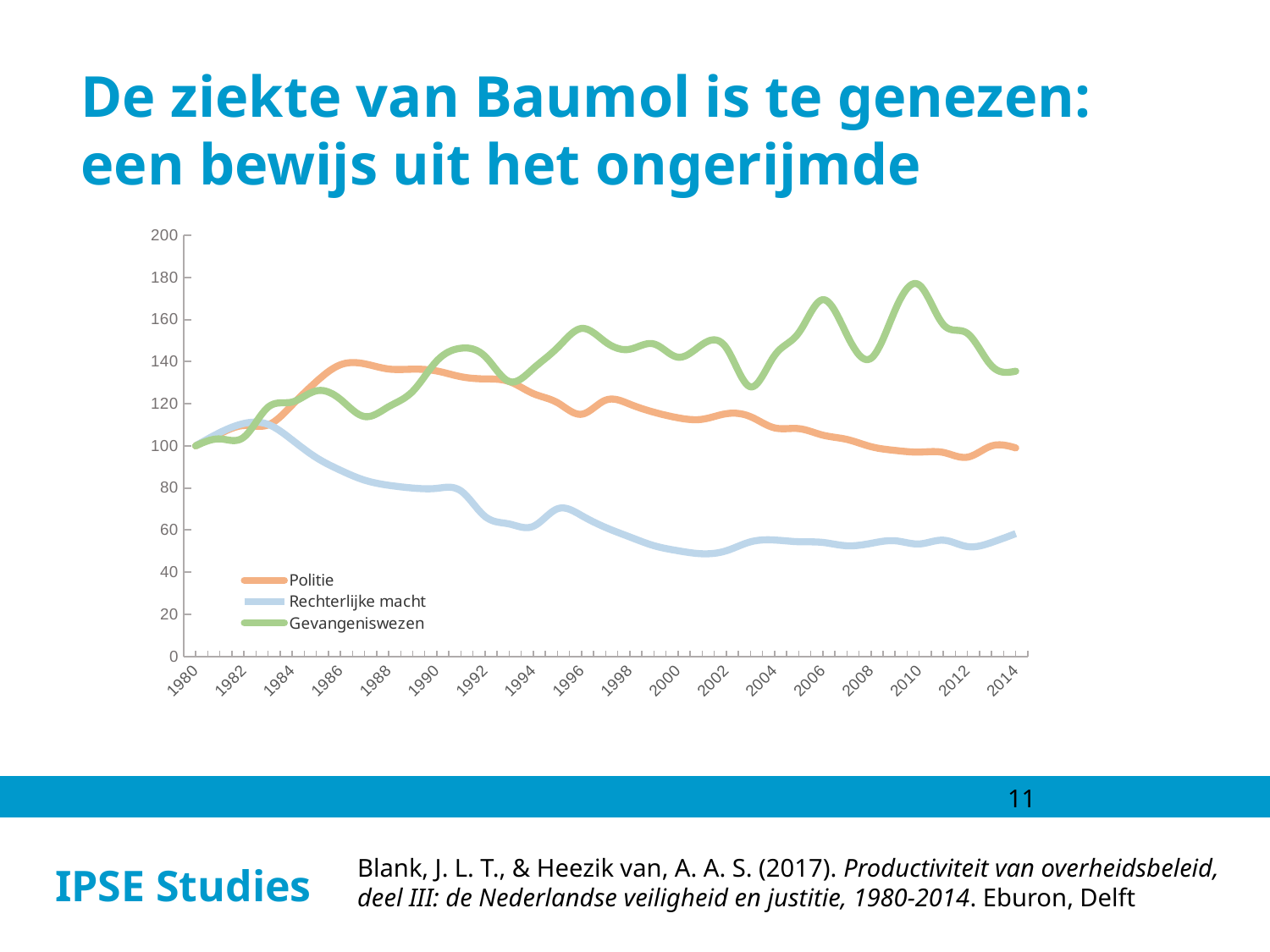
Is the value for Politie in 2014 greater or less than 120? less Does the Gevangeniswezen line rise or fall overall from 1980 to 2014? rise Which series is the highest in 2010? Gevangeniswezen Is the value for Gevangeniswezen in 2010 greater or less than 160? greater Is the value for Rechterlijke macht in 2000 greater or less than 60? less Does the Rechterlijke macht line rise or fall overall from 1980 to 2014? fall What kind of chart is shown on the slide? line chart What is the first year shown on the x axis? 1980 What colour is the Politie line? orange In 2014, which is larger: Gevangeniswezen or Politie? Gevangeniswezen Which series is the lowest in 2000? Rechterlijke macht How many series does the legend list? 3